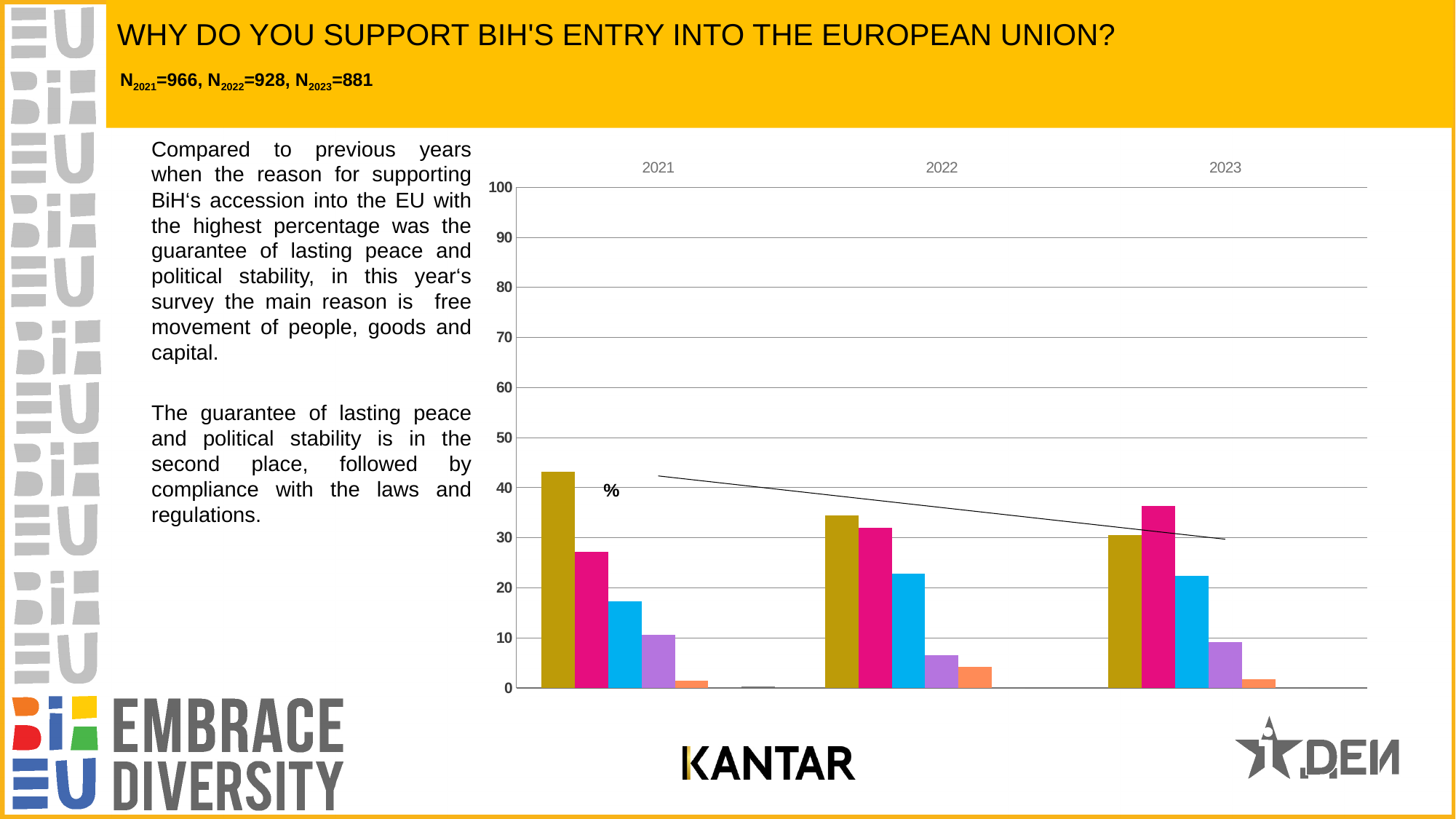
In which year is the gold (first) bar the highest? 2021 Does the pink (second) bar rise or fall from 2021 to 2023? rise Is the value of the gold (first) bar for 2023 greater or less than 40? less Which years are shown as categories on the chart's x axis? 2021, 2022, 2023 Is the value of the pink (second) bar for 2023 greater or less than 30? greater How many year categories are shown along the x axis of the chart? 3 Does the gold (first) bar rise or fall from 2021 to 2023? fall In 2021, which is larger: the gold (first) bar or the pink (second) bar? the gold bar In 2023, which is larger: the gold (first) bar or the pink (second) bar? the pink bar What kind of chart is shown on the slide? bar chart Is the value of the blue (third) bar for 2021 greater or less than 20? less